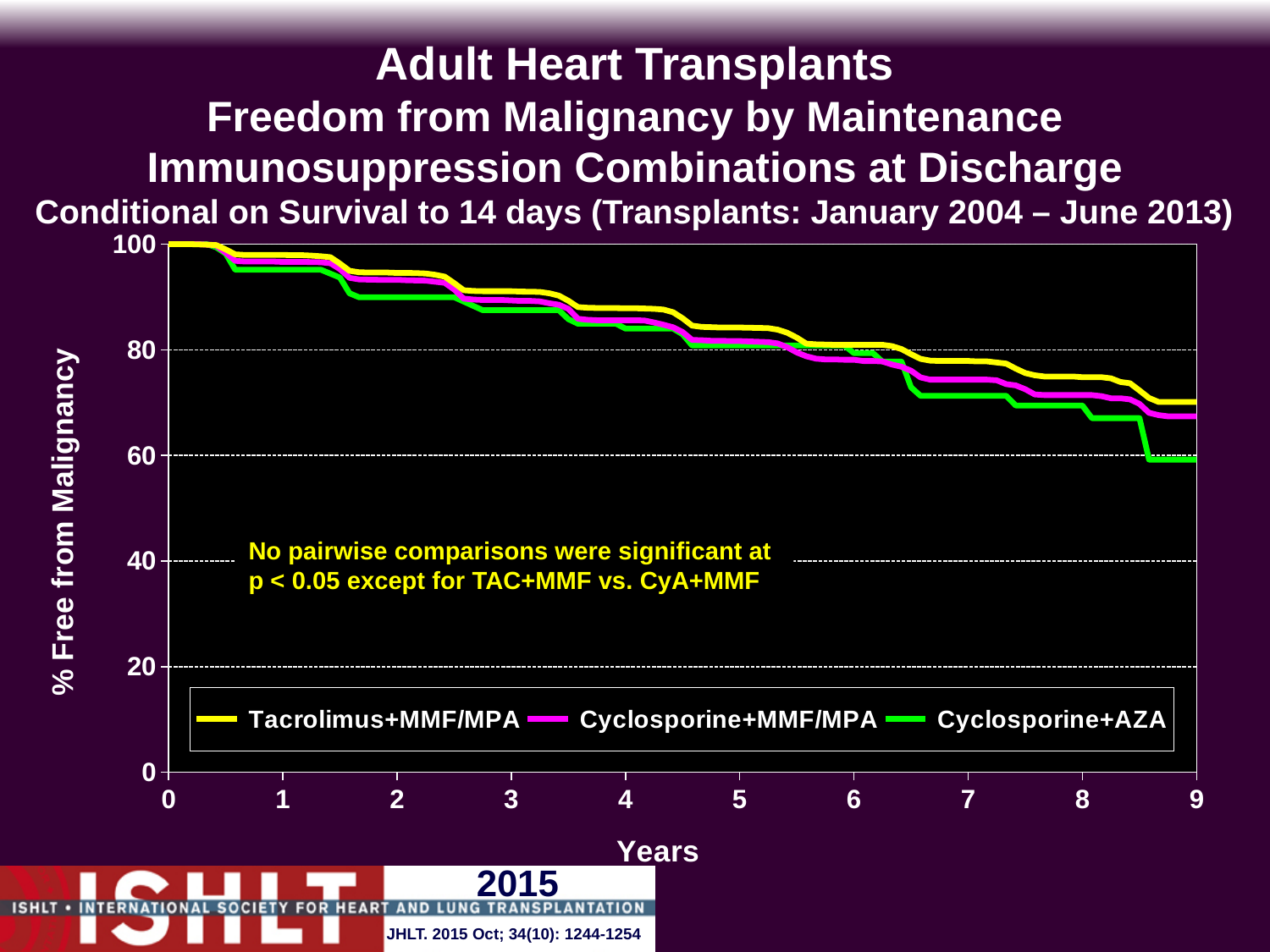
How many series does the legend list? 3 What is the label of the y-axis? % Free from Malignancy What is the largest value shown on the x-axis (Years)? 9 Which series has the lowest value at 9 years? Cyclosporine+AZA Is the value for Tacrolimus+MMF/MPA at 9 years greater or less than 60? greater Is the value for Cyclosporine+AZA at 9 years greater or less than 80? less Is the value for Cyclosporine+MMF/MPA at 1 year greater or less than 80? greater Do the values for Tacrolimus+MMF/MPA rise or fall as years increase? Fall What is the value for Cyclosporine+AZA at 0 years? 100 Which series is shown in green in the legend? Cyclosporine+AZA At 9 years, which is larger: the value for Tacrolimus+MMF/MPA or the value for Cyclosporine+AZA? Tacrolimus+MMF/MPA What kind of chart is shown on the slide? Line chart